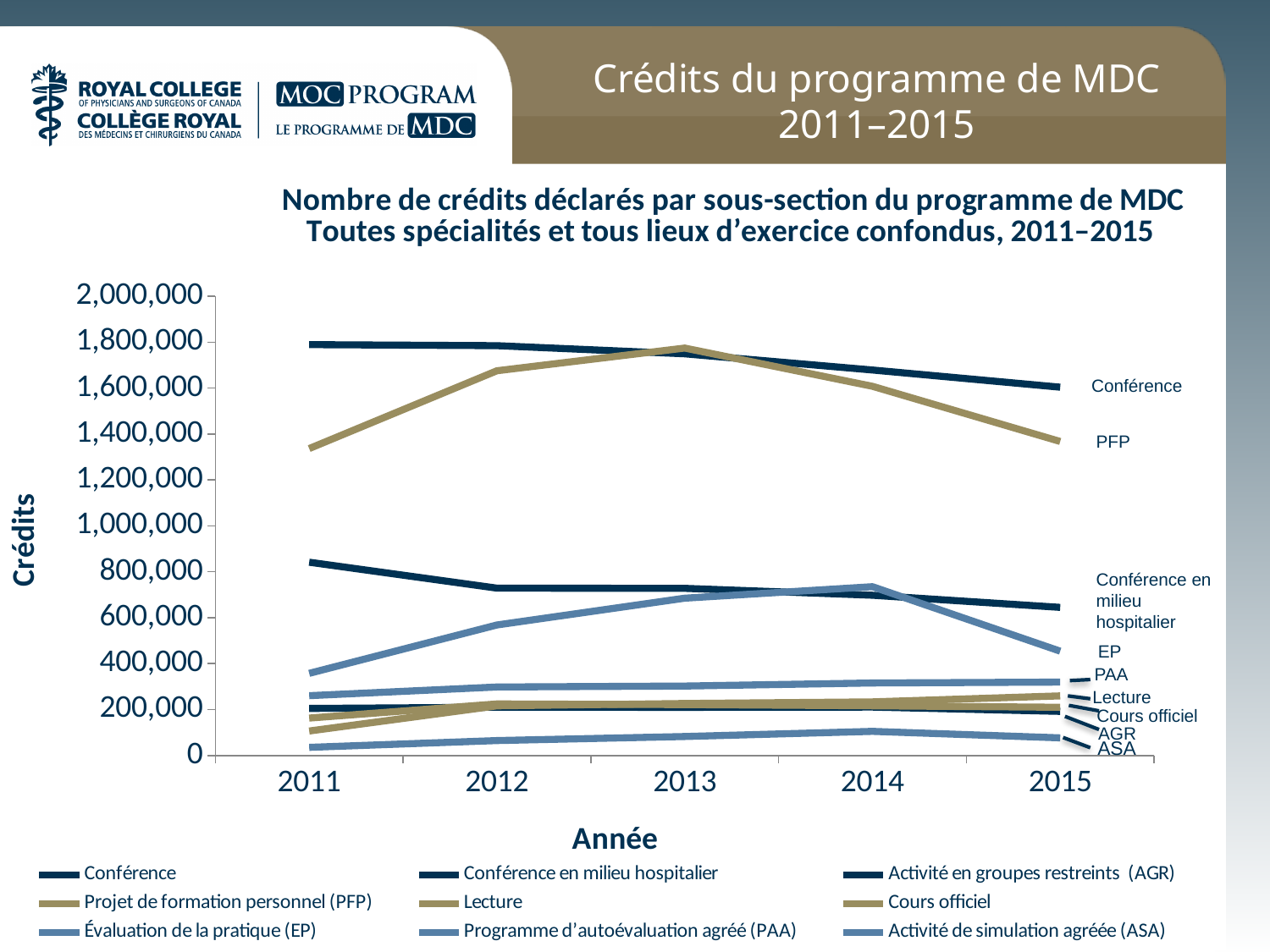
Which series has the lowest value in 2011? Activité de simulation agréée (ASA) Is the value for Conférence in 2011 greater or less than 1,600,000? greater How many years are plotted along the x axis? 5 In 2015, which is larger: Conférence en milieu hospitalier or Évaluation de la pratique (EP)? Conférence en milieu hospitalier Does the value for Projet de formation personnel (PFP) rise or fall from 2013 to 2015? Fall How many series does the legend list? 9 What kind of chart is shown on the slide? Line chart Is the value for Projet de formation personnel (PFP) in 2011 greater or less than 1,400,000? less What is the title of the x axis? Année Does the value for Évaluation de la pratique (EP) rise or fall from 2011 to 2014? Rise Is the value for Évaluation de la pratique (EP) in 2015 greater or less than 600,000? less Which series has the highest value in 2011? Conférence